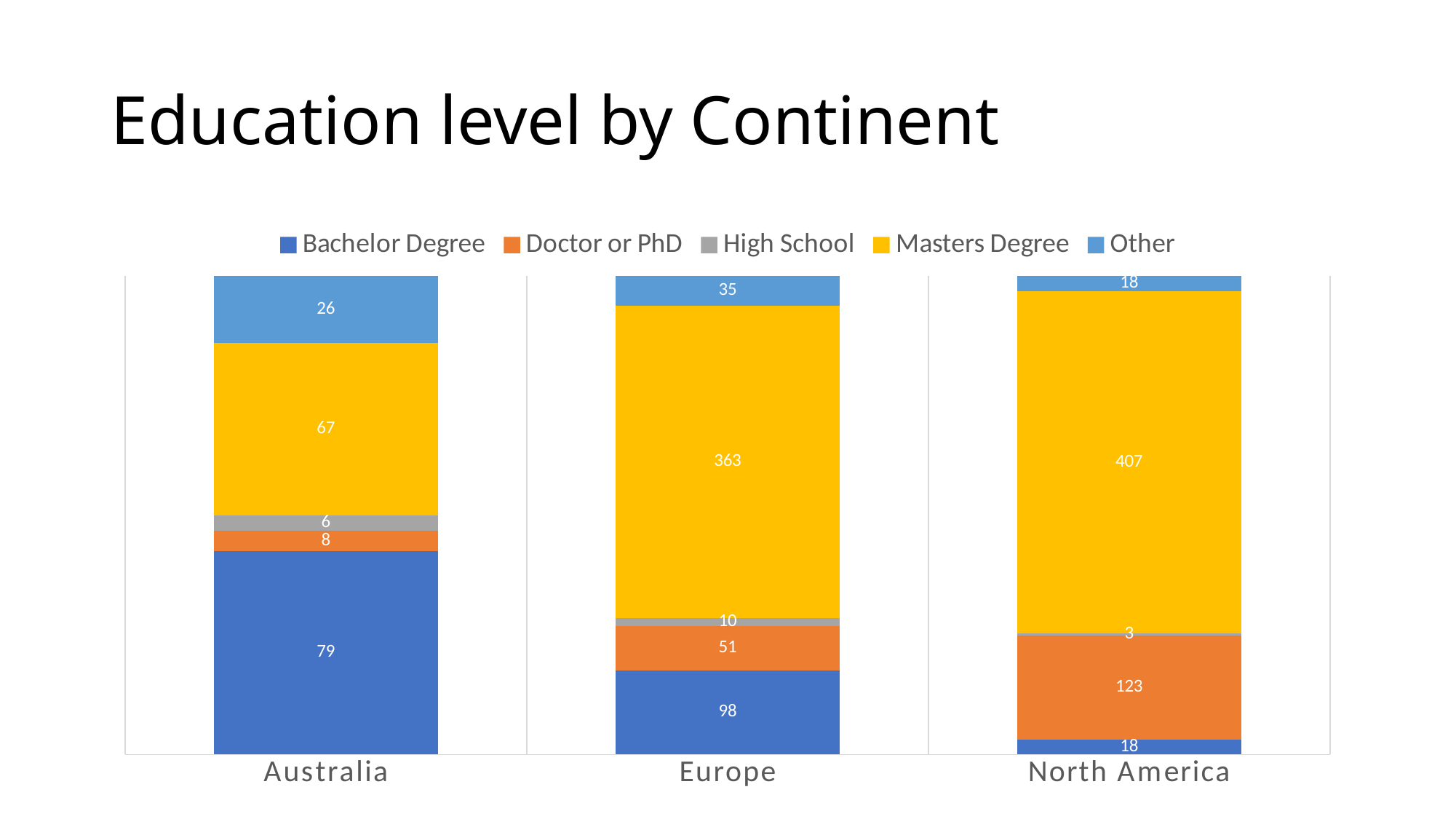
What is the Doctor or PhD value for North America? 123 What is the Bachelor Degree value for Australia? 79 Which is larger, the Doctor or PhD value for Europe or for Australia? Europe What kind of chart is shown on the slide? Stacked bar chart What is the High School value for North America? 3 What is the total of the labelled values in the Europe bar? 557 How many series does the legend list? 5 Which continent has the highest Masters Degree value? North America What is the difference between the Masters Degree values for North America and Europe? 44 How many continents are shown on the x axis? 3 Which continent has the lowest Bachelor Degree value? North America What is the Masters Degree value for Europe? 363